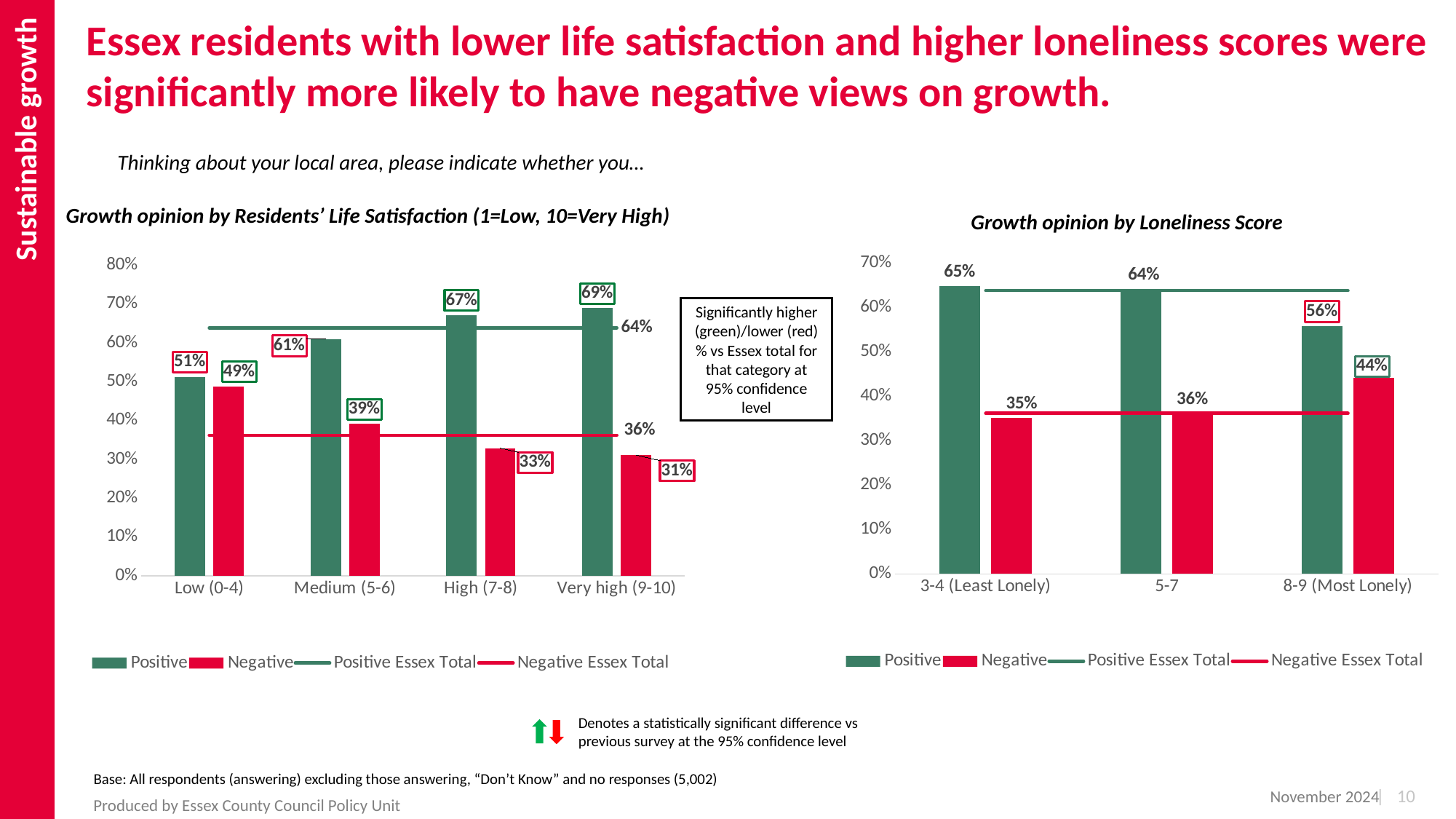
In the 'Growth opinion by Residents' Life Satisfaction' chart, what is the Negative value for Medium (5-6)? 39% In the 'Growth opinion by Residents' Life Satisfaction' chart, do the Positive values rise or fall as life satisfaction increases from Low to Very high? rise In the 'Growth opinion by Residents' Life Satisfaction' chart, what is the Positive value for Low (0-4)? 51% In the 'Growth opinion by Residents' Life Satisfaction' chart, how many life satisfaction categories are shown on the x axis? 4 In the 'Growth opinion by Residents' Life Satisfaction' chart, what is the difference between the Positive values for Very high (9-10) and Low (0-4)? 18 percentage points In the 'Growth opinion by Residents' Life Satisfaction' chart, which category has the highest Positive value? Very high (9-10) In the 'Growth opinion by Residents' Life Satisfaction' chart, which category has the lowest Negative value? Very high (9-10) In the 'Growth opinion by Loneliness Score' chart, how many series does the legend list? 4 What kind of chart is 'Growth opinion by Loneliness Score'? bar chart In the 'Growth opinion by Loneliness Score' chart, what is the Negative value for 8-9 (Most Lonely)? 44% In the 'Growth opinion by Loneliness Score' chart, which category has the lowest Positive value? 8-9 (Most Lonely) In the 'Growth opinion by Loneliness Score' chart, which is larger: the Positive value for 3-4 (Least Lonely) or the Positive value for 8-9 (Most Lonely)? 3-4 (Least Lonely)